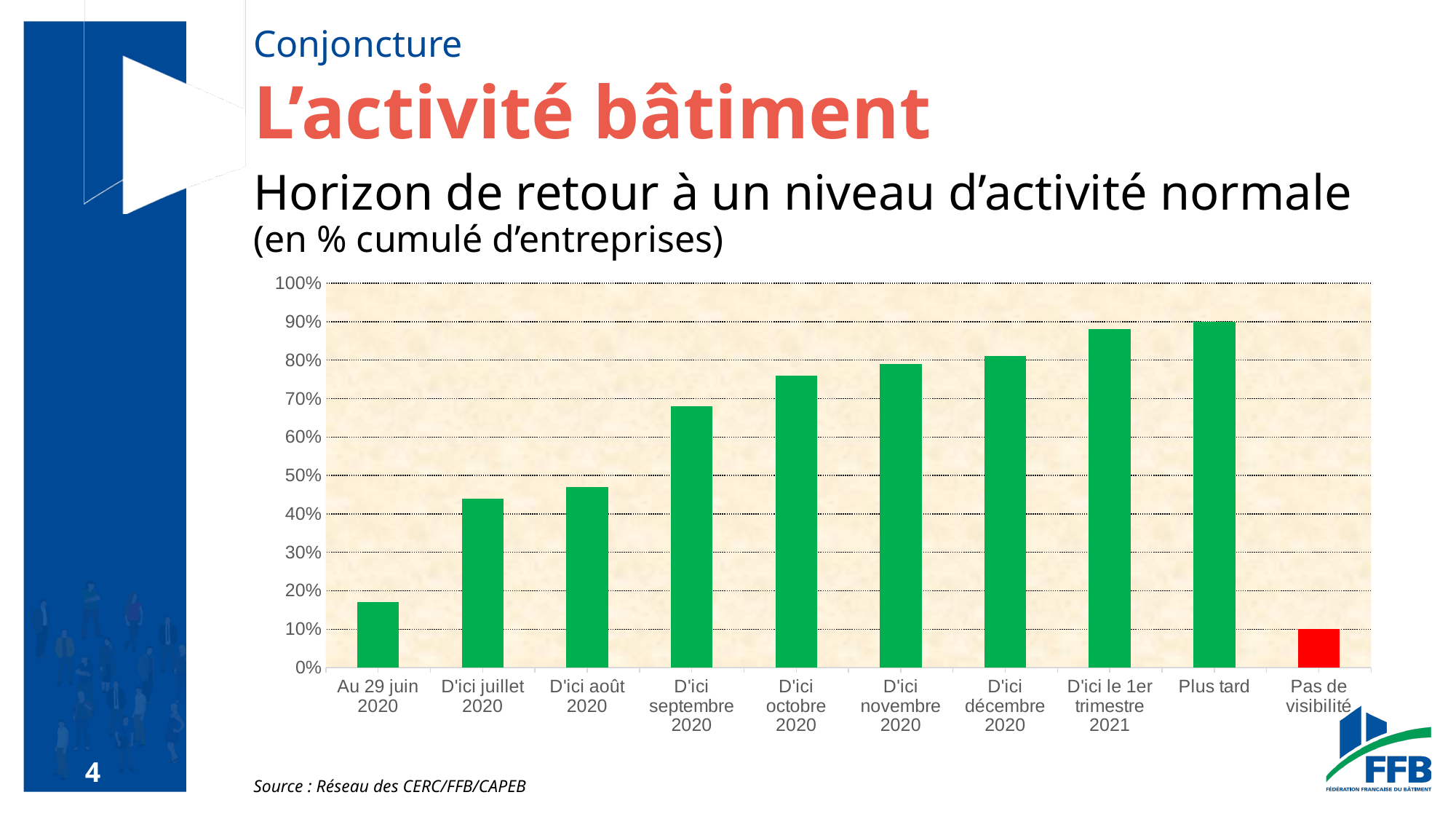
Which category has the highest bar in the chart? Plus tard Do the values rise or fall from "Au 29 juin 2020" through "Plus tard"? rise Is the value for "Au 29 juin 2020" greater or less than 20%? less Which category's bar is coloured red rather than green? Pas de visibilité What kind of chart is shown on the slide? bar chart Is the value for "D'ici le 1er trimestre 2021" greater or less than 80%? greater What is the title of the chart on the slide? Horizon de retour à un niveau d'activité normale (en % cumulé d'entreprises) Which is larger, the value for "D'ici août 2020" or the value for "D'ici octobre 2020"? D'ici octobre 2020 Is the value for "D'ici septembre 2020" greater or less than 60%? greater How many categories are shown on the x axis of the chart? 10 Which category has the lowest bar in the chart? Pas de visibilité